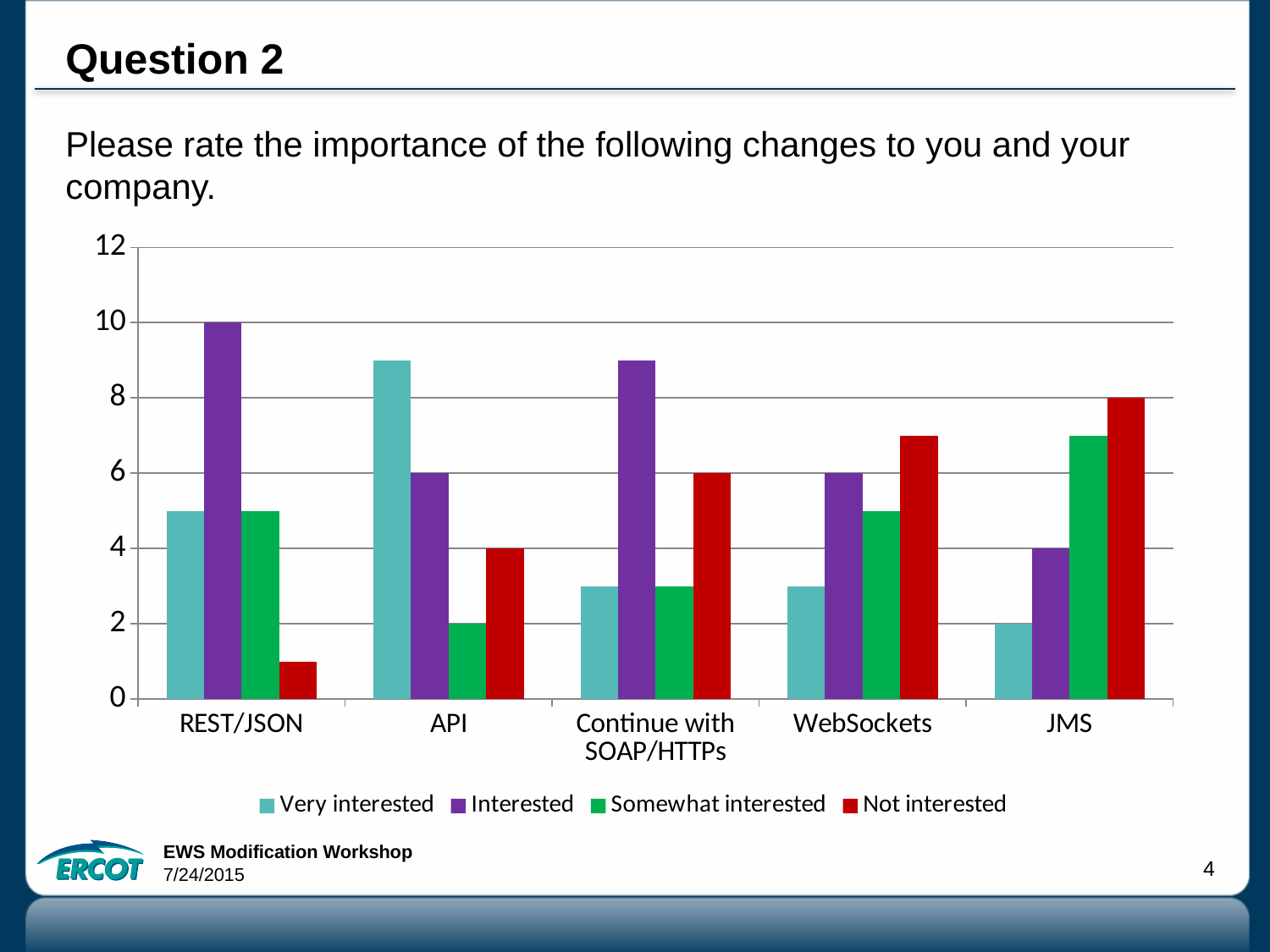
Is the Very interested value for API greater or less than 8? greater Which is larger for JMS, the Somewhat interested value or the Interested value? Somewhat interested How many series does the legend list? 4 How many categories are shown on the x axis? 5 Which category has the lowest Not interested value? REST/JSON What is the value of the Somewhat interested series for API? 2 What is the value of the Interested series for WebSockets? 6 What is the value of the Interested series for REST/JSON? 10 Which category has the highest Very interested value? API What is the difference between the Interested and Somewhat interested values for API? 4 Which category has the highest Interested value? REST/JSON What is the value of the Not interested series for JMS? 8